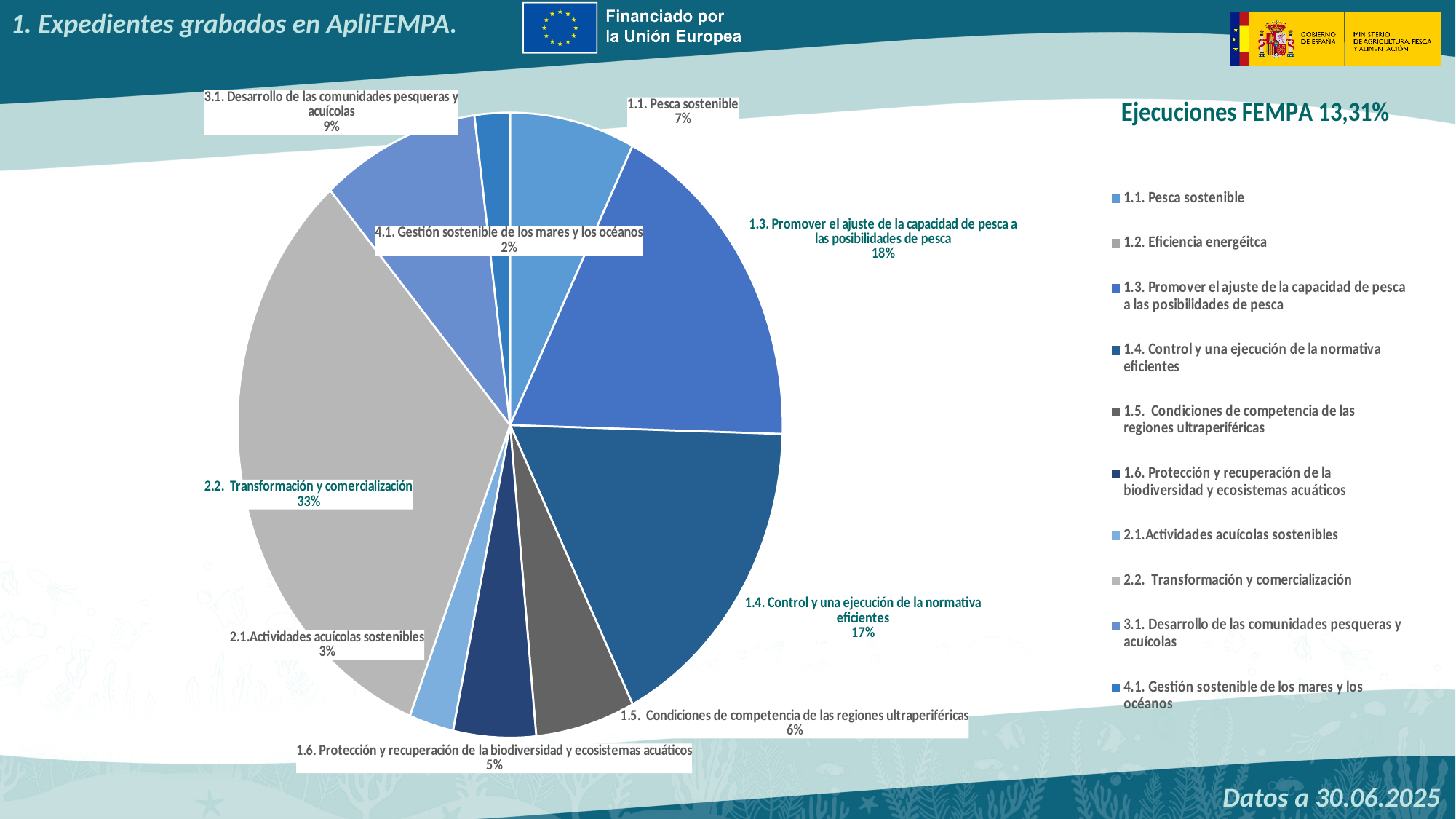
Which labelled slice has the smallest percentage? 4.1. Gestión sostenible de los mares y los océanos What percentage is shown for "1.6. Protección y recuperación de la biodiversidad y ecosistemas acuáticos"? 5% Which is larger, the share for "1.1. Pesca sostenible" or the share for "1.5. Condiciones de competencia de las regiones ultraperiféricas"? 1.1. Pesca sostenible What percentage is shown for "1.3. Promover el ajuste de la capacidad de pesca a las posibilidades de pesca"? 18% What kind of chart is shown on the slide? pie chart How many entries does the legend list? 10 What is the title shown above the legend on the right of the chart? Ejecuciones FEMPA 13,31% What share of the pie does "2.2. Transformación y comercialización" represent? 33% What percentage is shown for "1.4. Control y una ejecución de la normativa eficientes"? 17% What percentage is shown for "3.1. Desarrollo de las comunidades pesqueras y acuícolas"? 9% Which category has the largest slice of the pie? 2.2. Transformación y comercialización What is the difference in percentage points between "2.2. Transformación y comercialización" and "1.3. Promover el ajuste de la capacidad de pesca a las posibilidades de pesca"? 15